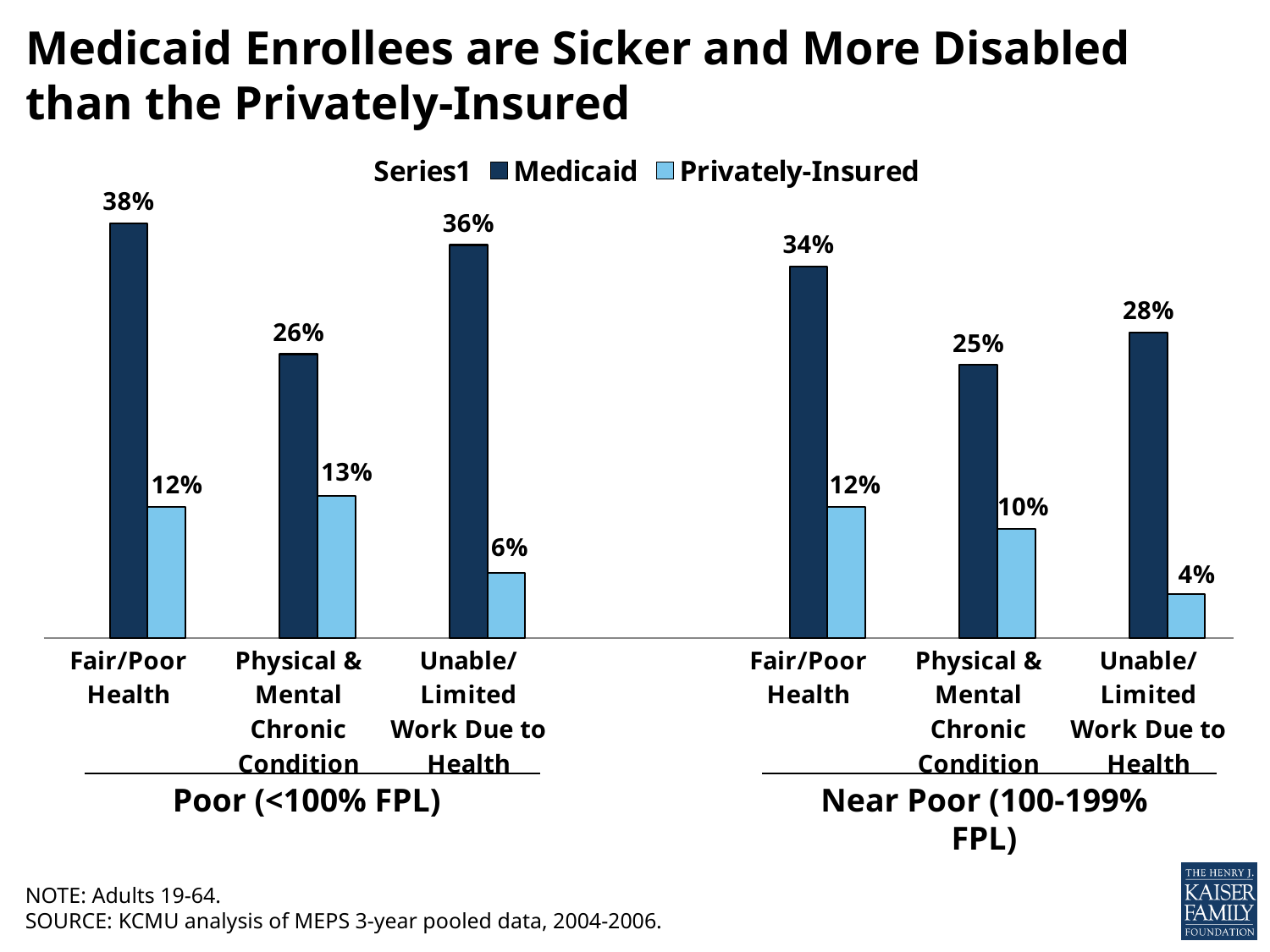
What is the Privately-Insured value for Unable/Limited Work Due to Health in the Near Poor (100-199% FPL) group? 4% What is the difference between the Medicaid and Privately-Insured values for Unable/Limited Work Due to Health in the Poor (<100% FPL) group? 30% What is the Privately-Insured value for Physical & Mental Chronic Condition in the Poor (<100% FPL) group? 13% What is the Medicaid value for Physical & Mental Chronic Condition in the Near Poor (100-199% FPL) group? 25% Which category has the highest Medicaid value across the whole chart? Fair/Poor Health (Poor <100% FPL) What kind of chart is shown on the slide? Bar chart What is the difference between the Medicaid values for Fair/Poor Health in the Poor group and the Near Poor group? 4% Which category has the lowest Privately-Insured value across the whole chart? Unable/Limited Work Due to Health (Near Poor 100-199% FPL) Which is larger: the Medicaid value for Physical & Mental Chronic Condition in the Poor group or in the Near Poor group? Poor group How many categories are shown in the Near Poor (100-199% FPL) group? 3 What is the Medicaid value for Fair/Poor Health in the Poor (<100% FPL) group? 38% Which series is shown in light blue in the legend? Privately-Insured